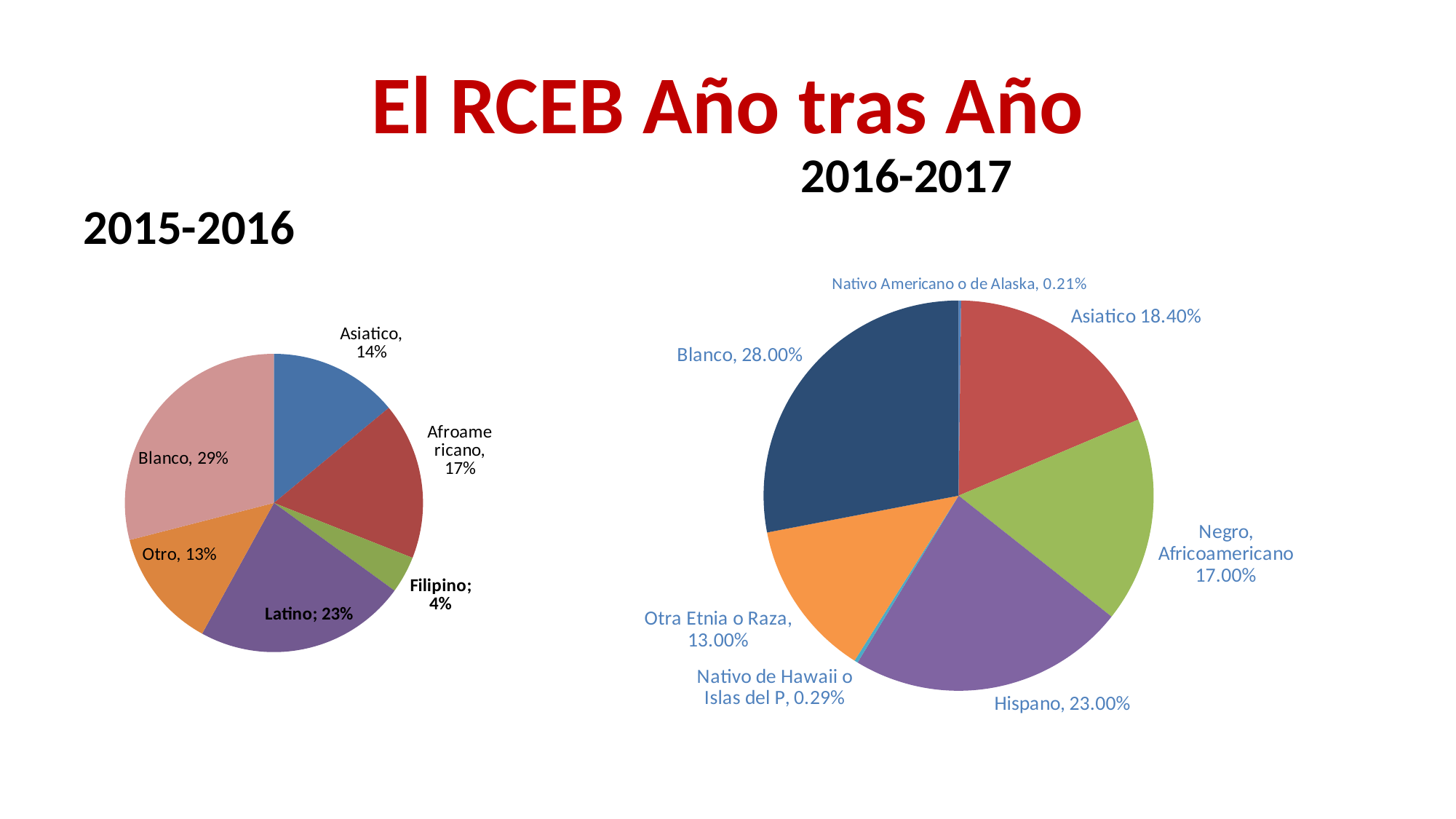
In the 2016-2017 pie chart, which category has the smallest share? Nativo Americano o de Alaska How many slices does the 2015-2016 pie chart have? 6 How many slices does the 2016-2017 pie chart have? 7 In the 2016-2017 pie chart, what percentage is shown for Nativo de Hawaii o Islas del P? 0.29% In the 2015-2016 pie chart, which category has the largest share? Blanco What type of chart is used for the 2016-2017 data? Pie chart In the 2016-2017 pie chart, what is the difference between the Blanco and Hispano percentages? 5.00% In the 2015-2016 pie chart, what percentage is shown for Filipino? 4% In the 2015-2016 pie chart, what is the difference between the Latino and Otro percentages? 10% In the 2016-2017 pie chart, what percentage is shown for Asiatico? 18.40% In the 2015-2016 pie chart, what percentage is shown for Blanco? 29% In the 2016-2017 pie chart, which is larger, Asiatico or Negro, Africoamericano? Asiatico